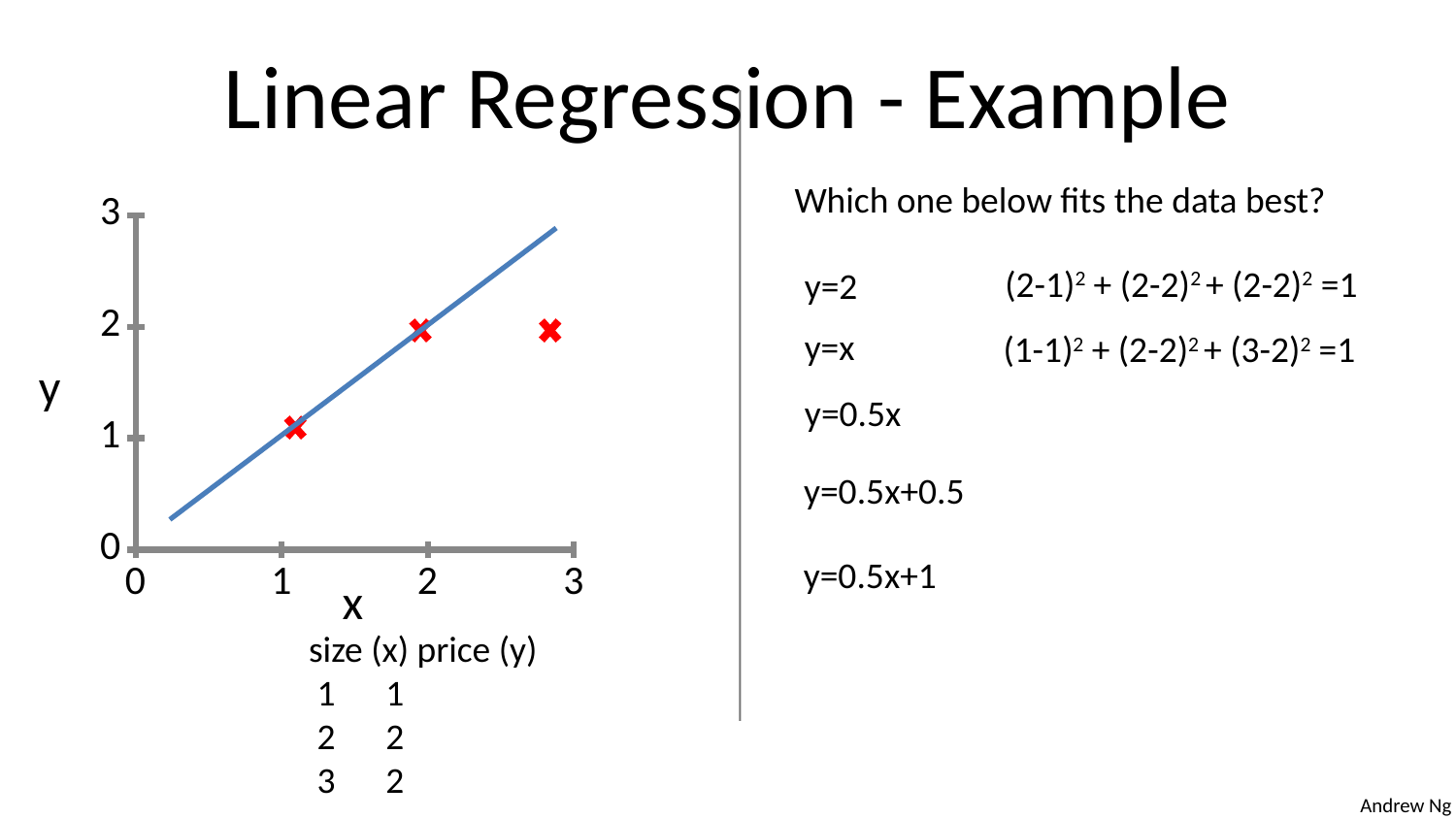
What is the price (y) for size (x) = 1? 1 Is the value for size (x) = 3 greater or less than 3 on the y axis? less Is the price (y) for size (x) = 2 larger than the price (y) for size (x) = 1? yes What is the difference in price (y) between size (x) = 2 and size (x) = 1? 1 How many data points are plotted on the chart? 3 What is the price (y) for size (x) = 2? 2 What is the highest tick value shown on the y axis? 3 Which size (x) has the lowest price (y)? 1 What is the label on the horizontal axis of the chart? x What is the price (y) for size (x) = 3? 2 What kind of chart is shown on the slide? scatter chart Do the plotted y values rise or fall as x increases from 1 to 2? rise